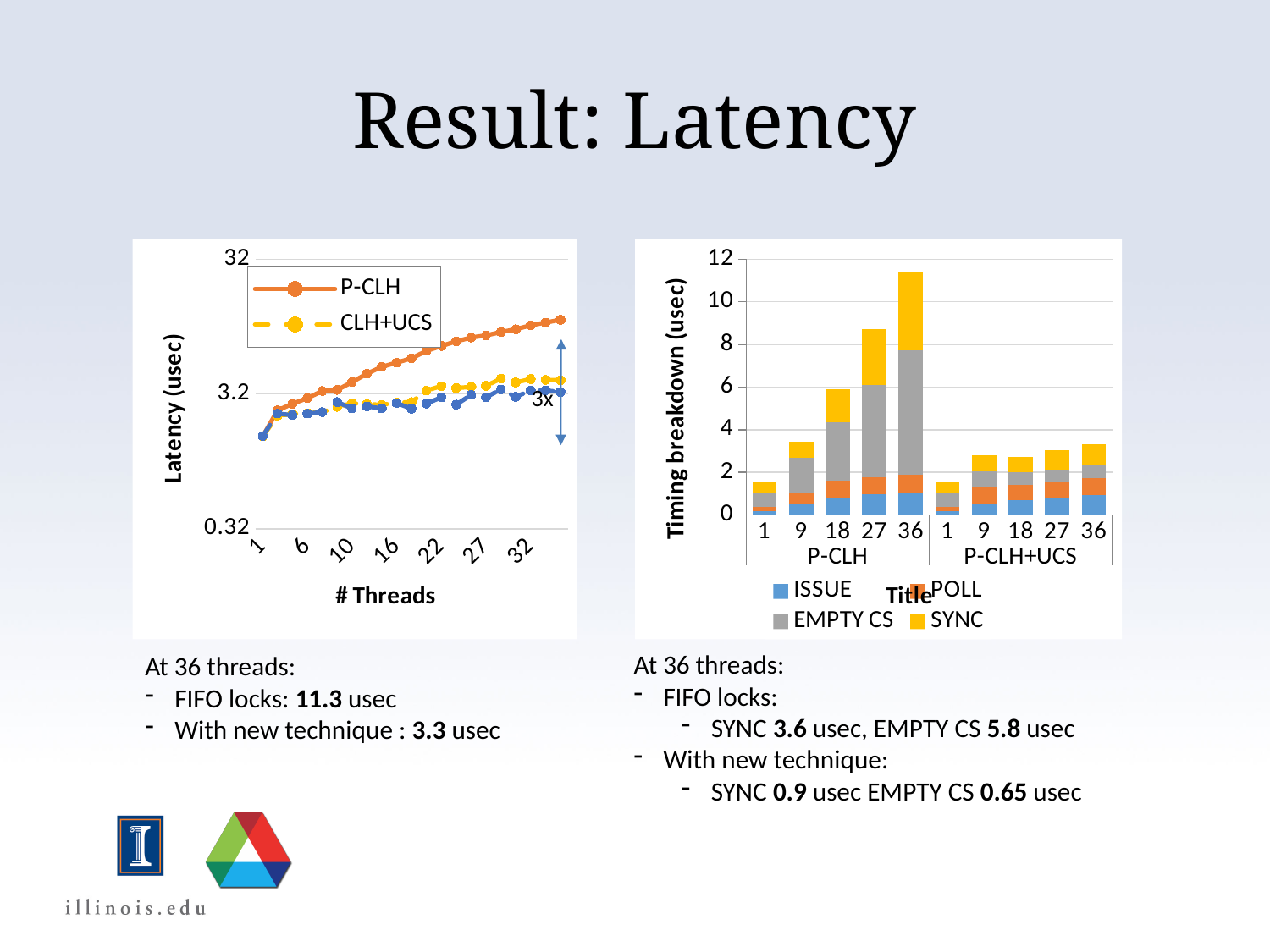
What kind of chart is the left chart on the slide? line chart What is the y-axis label of the left chart? Latency (usec) What kind of chart is the right chart on the slide? stacked bar chart In the right chart, which is larger at 36 threads: the P-CLH bar or the P-CLH+UCS bar? P-CLH How many series does the legend of the left chart list? 2 In the right chart, do the P-CLH bars rise or fall as the thread count goes from 1 to 36? rise In the right chart, is the total for P-CLH+UCS at 36 threads greater or less than 4? less How many bars are plotted in the right chart? 10 In the right chart, which bar is the tallest? P-CLH at 36 threads How many series does the legend of the right chart list? 4 In the right chart, is the total for P-CLH at 36 threads greater or less than 10? greater In the left chart, does the P-CLH latency rise or fall as the number of threads increases? rise